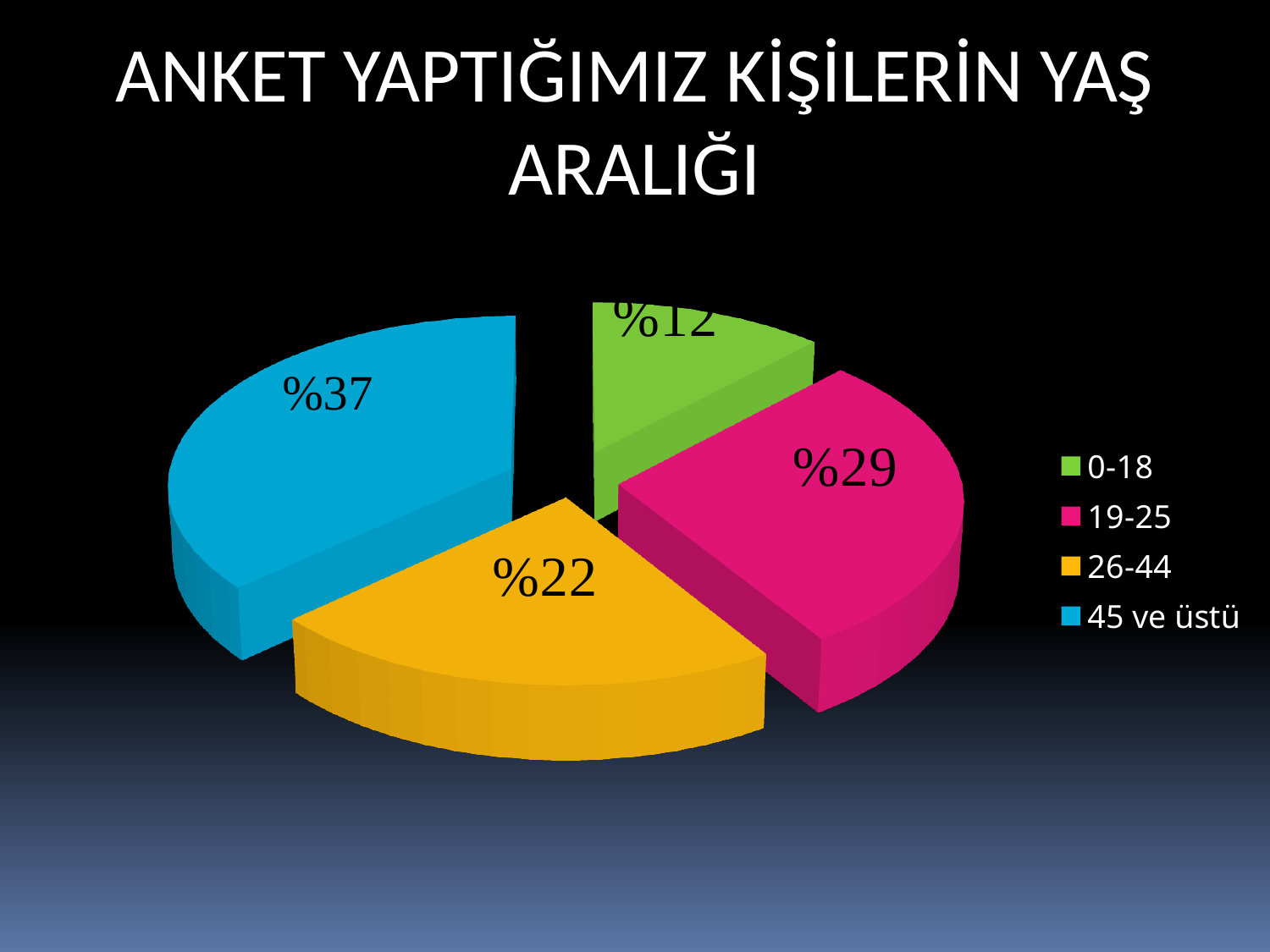
What colour is the slice for 26-44? orange Which is larger, the share for 19-25 or the share for 26-44? 19-25 What is the difference between the 45 ve üstü share and the 19-25 share? %8 What kind of chart is shown on the slide? pie chart What is the value shown for the 19-25 slice? %29 Which age group has the smallest share of the pie? 0-18 Which age group has the largest share of the pie? 45 ve üstü What is the value shown for the 0-18 slice? %12 How many entries does the legend list? 4 How many slices does the pie chart have? 4 What is the value shown for the 45 ve üstü slice? %37 What is the value shown for the 26-44 slice? %22